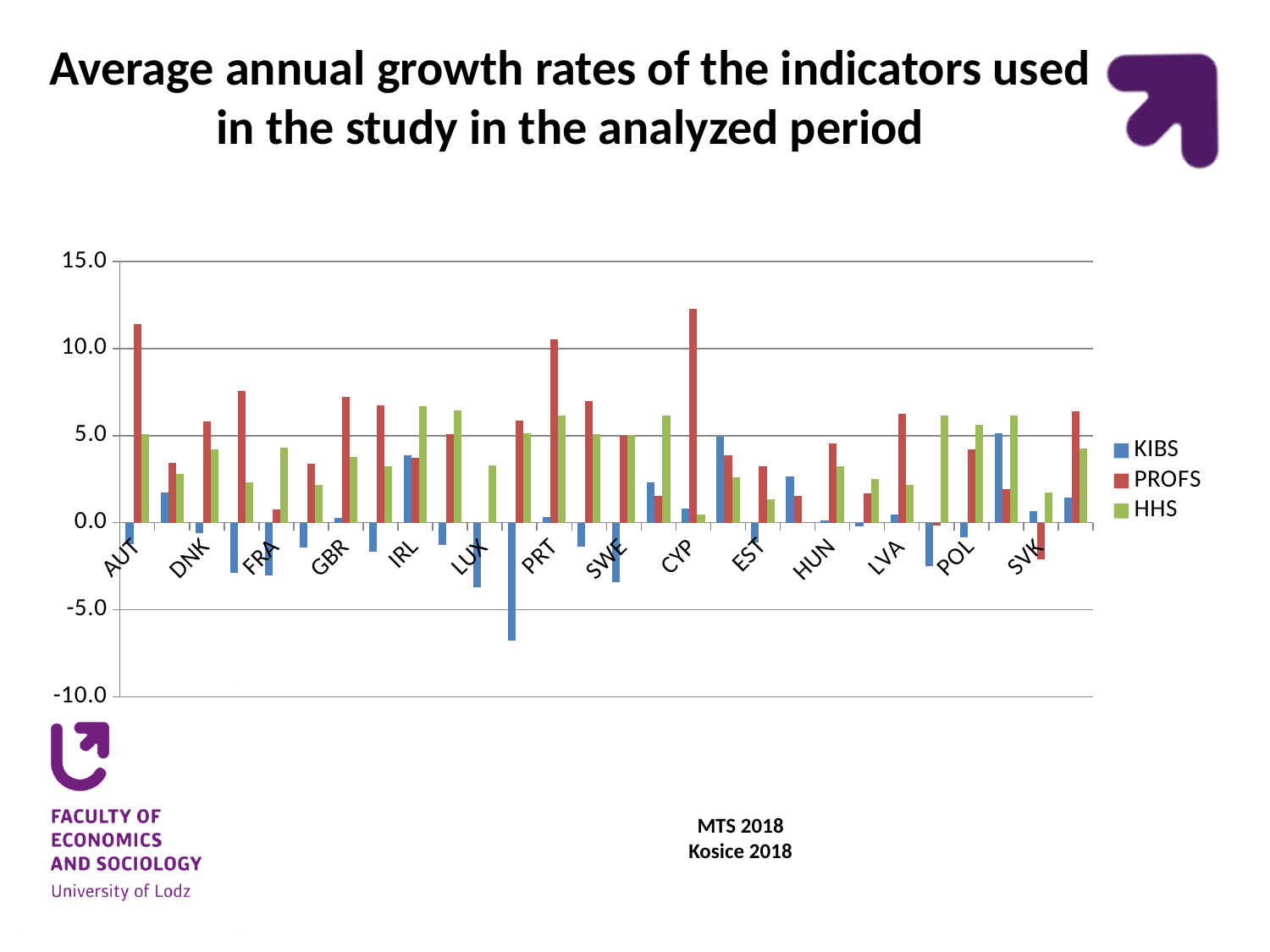
Which series is shown in green? HHS Is the KIBS value for LUX greater or less than 0.0? less How many series does the legend list? 3 For CYP, which is larger: the PROFS value or the KIBS value? PROFS For AUT, which series has the highest value? PROFS Is the PROFS value for AUT greater or less than 10.0? greater Is the HHS value for IRL greater or less than 5.0? greater What are the three series named in the legend? KIBS, PROFS, HHS What kind of chart is shown on the slide? bar chart